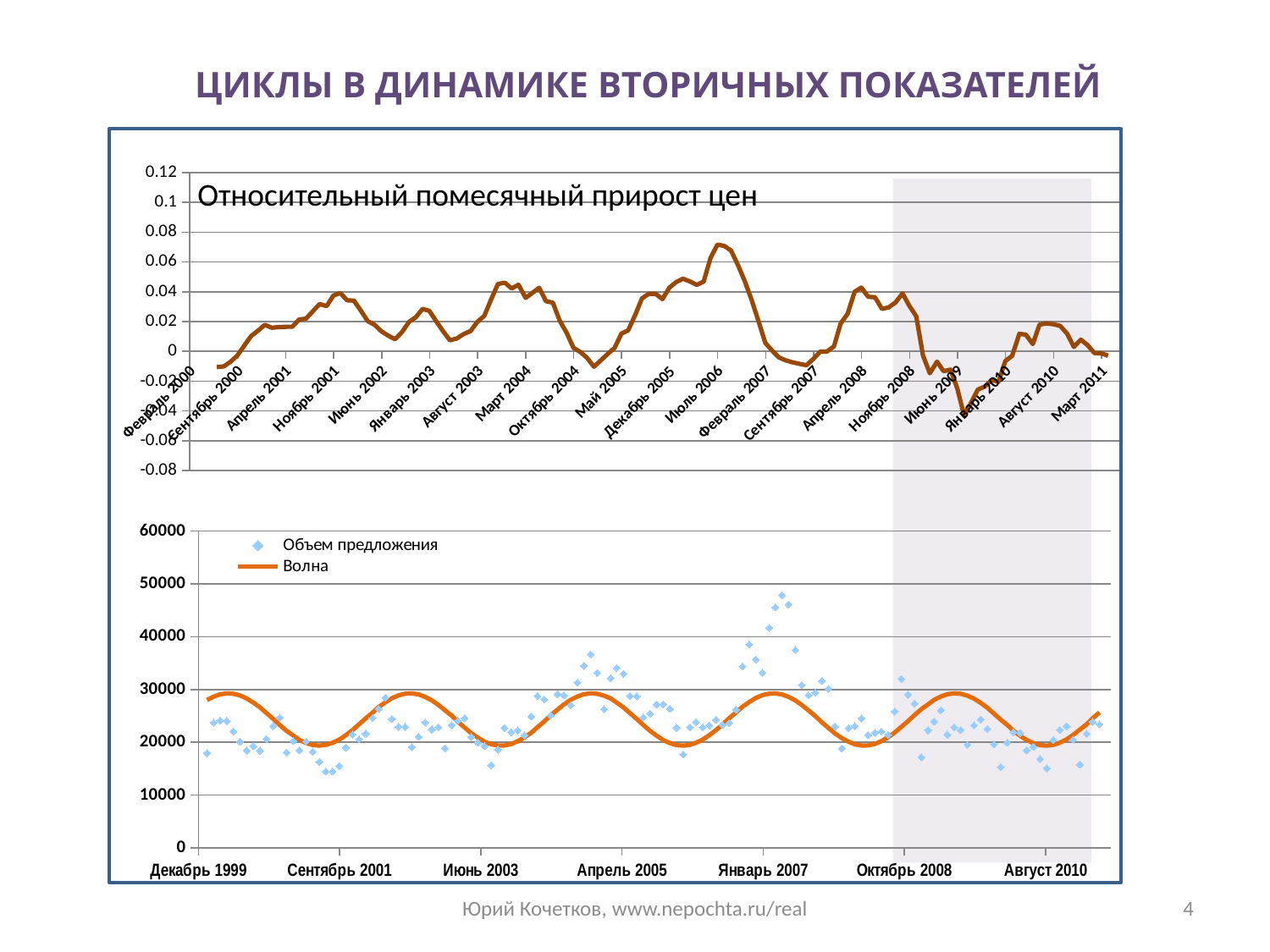
What is the highest value shown on the y axis of the bottom chart? 60000 What is the title of the top chart? Относительный помесячный прирост цен In the top chart 'Относительный помесячный прирост цен', is the value around Июль 2006 greater or less than 0.06? greater In the bottom chart, is the highest 'Объем предложения' point near Январь 2007 greater or less than 40000? greater How many series does the legend of the bottom chart list? 2 In the top chart 'Относительный помесячный прирост цен', does the line rise or fall between Февраль 2007 and Сентябрь 2007? fall What kind of chart is the top chart, titled 'Относительный помесячный прирост цен'? line chart In the top chart 'Относительный помесячный прирост цен', is the value at Март 2011 greater or less than 0.02? less What are the two series named in the legend of the bottom chart? Объем предложения, Волна